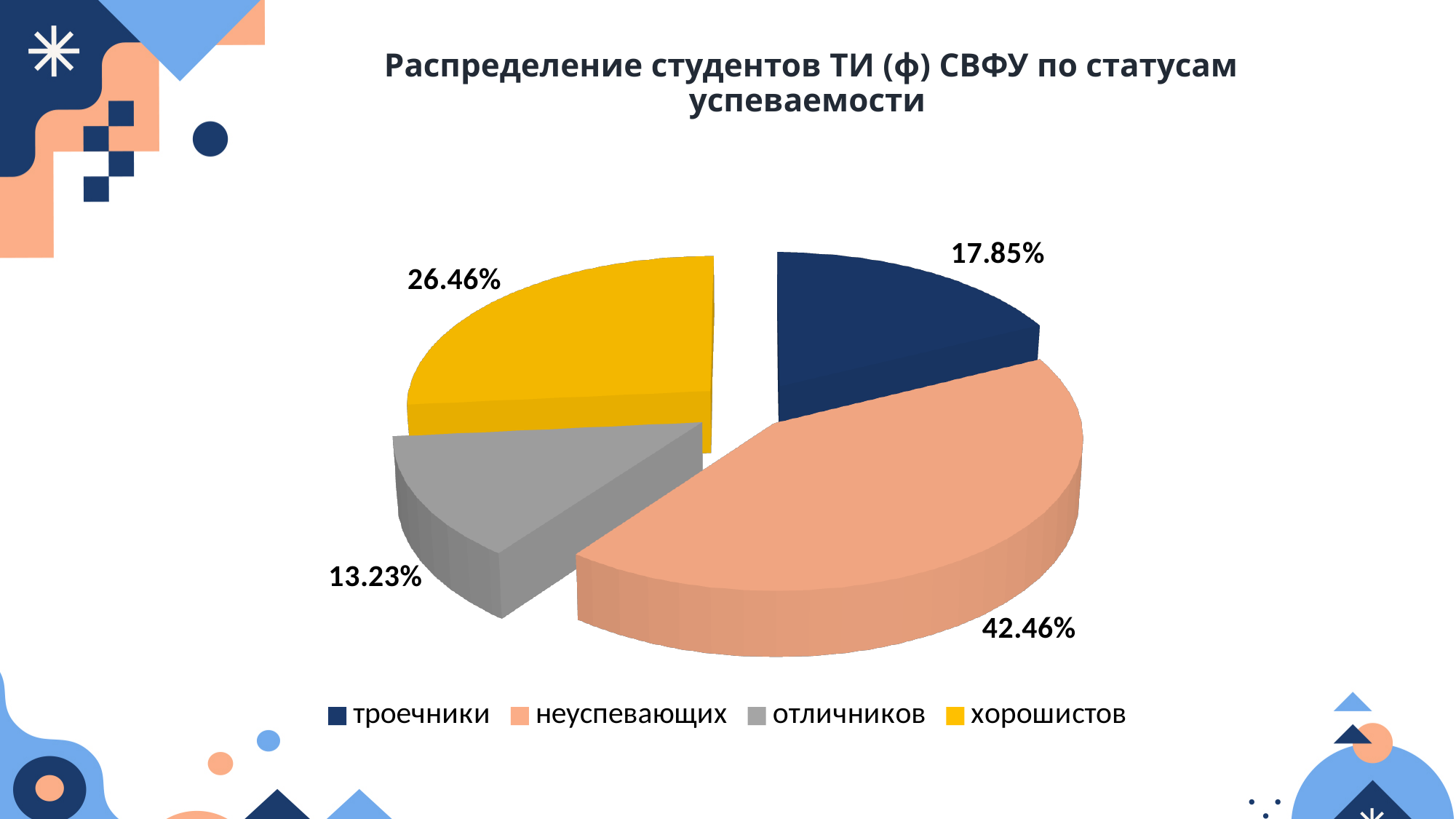
What colour is the slice for хорошистов? yellow Which category has the largest slice of the pie chart? неуспевающих How many categories does the pie chart show? 4 What is the share of троечники in the pie chart? 17.85% What is the difference between the share of неуспевающих and the share of отличников? 29.23% Which is larger: the share of хорошистов or the share of троечники? хорошистов What is the share of неуспевающих in the pie chart? 42.46% What is the title of the chart? Распределение студентов ТИ (ф) СВФУ по статусам успеваемости Which category has the smallest slice of the pie chart? отличников What is the share of отличников in the pie chart? 13.23% What kind of chart is shown on the slide? pie chart What is the share of хорошистов in the pie chart? 26.46%